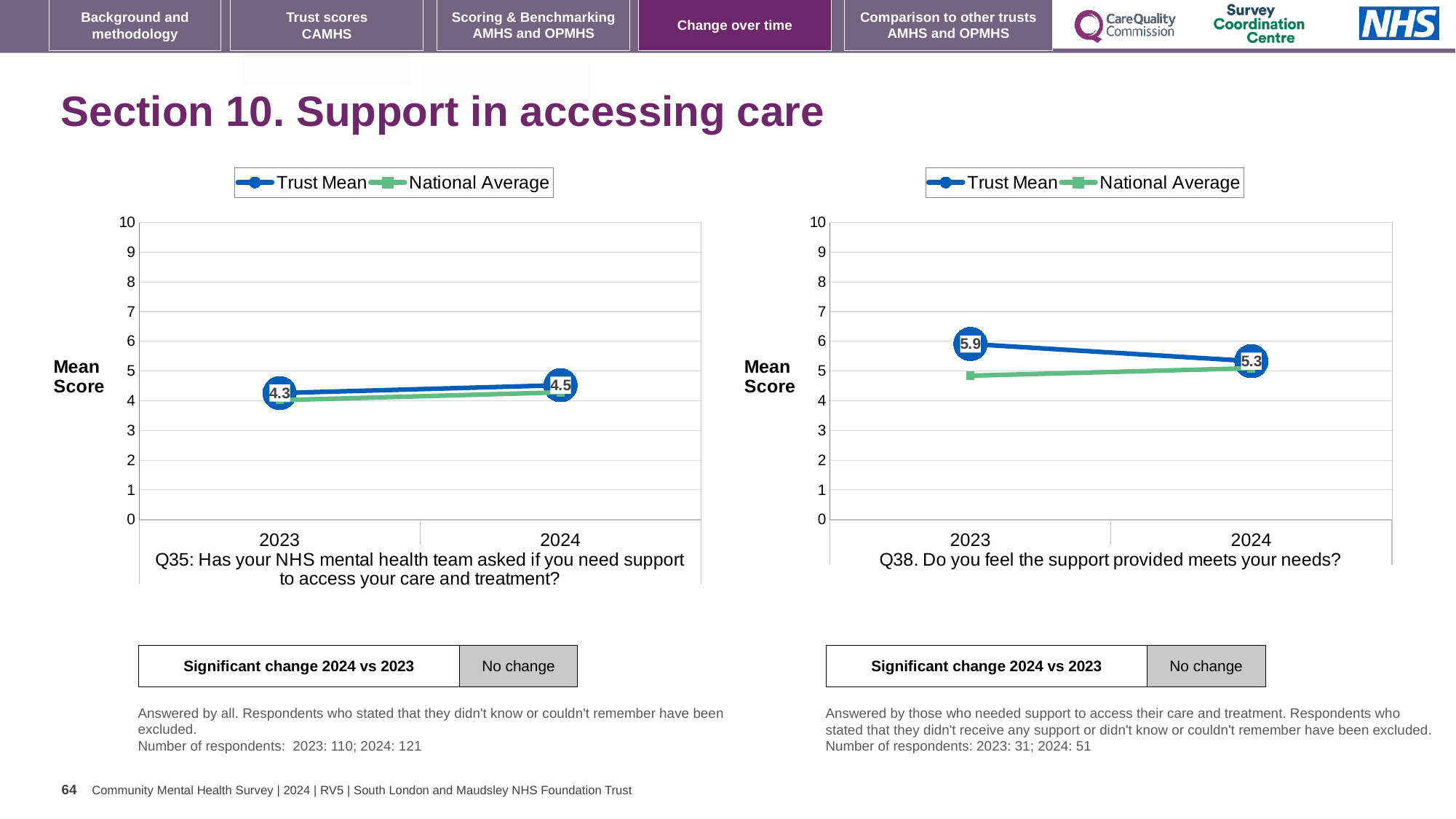
In the Q38 chart (right), is the National Average for 2023 greater or less than 5? less In the Q35 chart (left), by how much did the Trust Mean rise from 2023 to 2024? 0.2 In the Q38 chart (right), what is the Trust Mean for 2023? 5.9 In the Q35 chart (left), does the Trust Mean rise or fall from 2023 to 2024? rise In the Q38 chart (right), by how much did the Trust Mean fall from 2023 to 2024? 0.6 In the Q38 chart (right), does the Trust Mean rise or fall from 2023 to 2024? fall How many series does the legend of the Q35 chart (left) list? 2 In the Q38 chart (right), what is the Trust Mean for 2024? 5.3 In the Q38 chart (right), which year has the higher Trust Mean, 2023 or 2024? 2023 What kind of chart is the Q38 chart (right)? line chart In the Q35 chart (left), what is the Trust Mean for 2024? 4.5 In the Q35 chart (left), what is the Trust Mean for 2023? 4.3